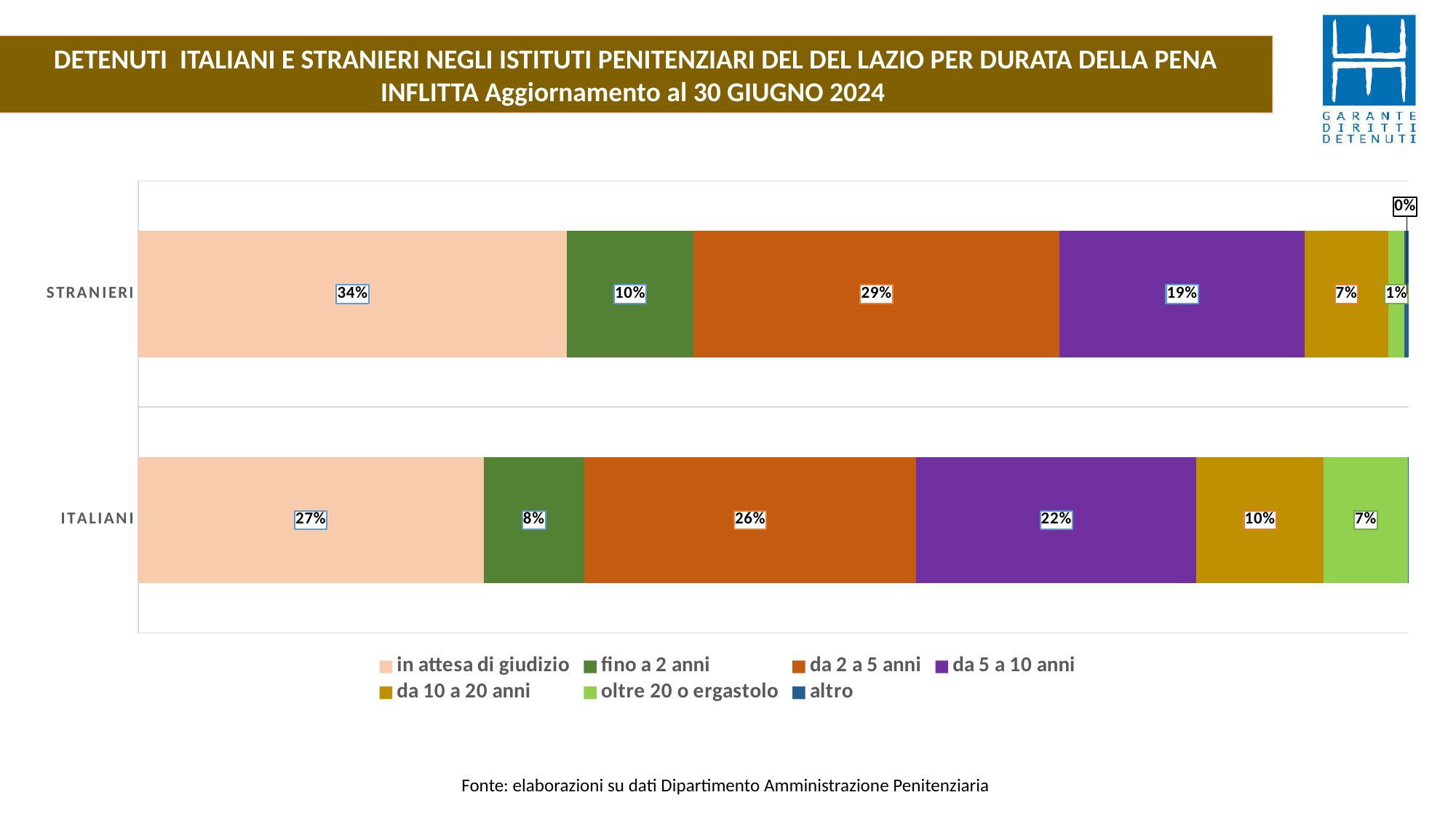
What is the value of 'da 10 a 20 anni' for STRANIERI? 7% What is the value of 'altro' for STRANIERI? 0% What is the value of 'oltre 20 o ergastolo' for ITALIANI? 7% How many series does the legend list? 7 How many categories (bars) are shown in the chart? 2 Which series has the highest value in the STRANIERI bar? in attesa di giudizio Which group has the larger value for 'da 5 a 10 anni', STRANIERI or ITALIANI? ITALIANI What is the value of 'in attesa di giudizio' for STRANIERI? 34% What is the difference between the 'in attesa di giudizio' values for STRANIERI and ITALIANI? 7% What kind of chart is shown on the slide? stacked bar chart Which series has the lowest labelled value in the ITALIANI bar? oltre 20 o ergastolo What is the value of 'da 5 a 10 anni' for ITALIANI? 22%